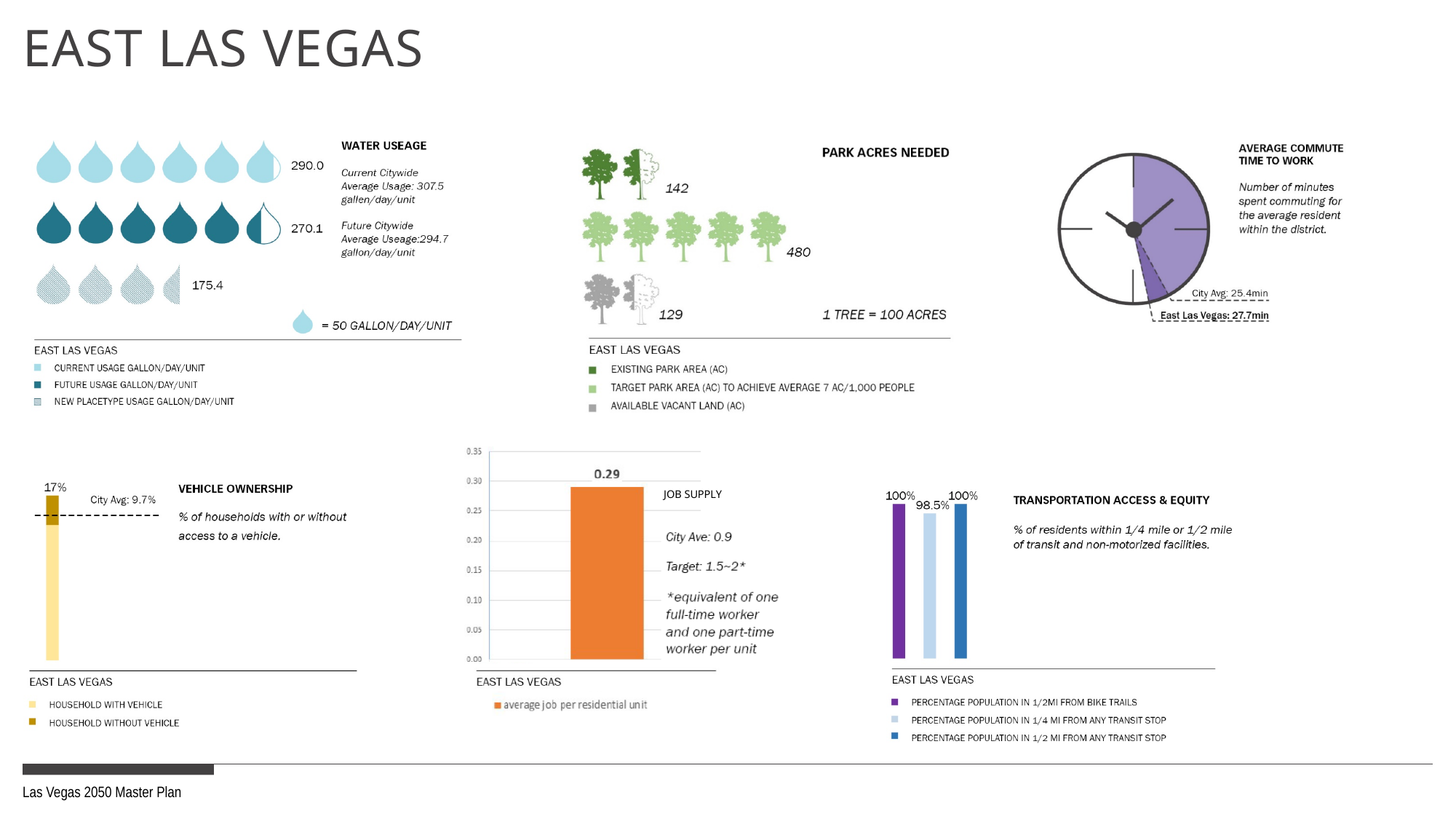
In the Transportation Access & Equity chart, what percentage of the population is within 1/4 mi from any transit stop? 98.5% In the Water Useage chart, what is the difference between the current usage and the future usage in gallon/day/unit? 19.9 In the Job Supply chart, what is the average job per residential unit for East Las Vegas? 0.29 In the Park Acres Needed chart, which is larger: existing park area or available vacant land? Existing park area In the Average Commute Time to Work chart, what is the average commute time for East Las Vegas? 27.7min In the Water Useage chart, what is the new placetype usage in gallon/day/unit? 175.4 What kind of chart is the Job Supply chart? Bar chart In the Water Useage chart, which of the three usage values is the lowest? New placetype usage gallon/day/unit How many series does the legend of the Transportation Access & Equity chart list? 3 In the Vehicle Ownership chart, what percentage of households are without a vehicle in East Las Vegas? 17% In the Water Useage chart, what is the current usage in gallon/day/unit for East Las Vegas? 290.0 In the Park Acres Needed chart, what is the target park area (ac) to achieve average 7 ac/1,000 people? 480